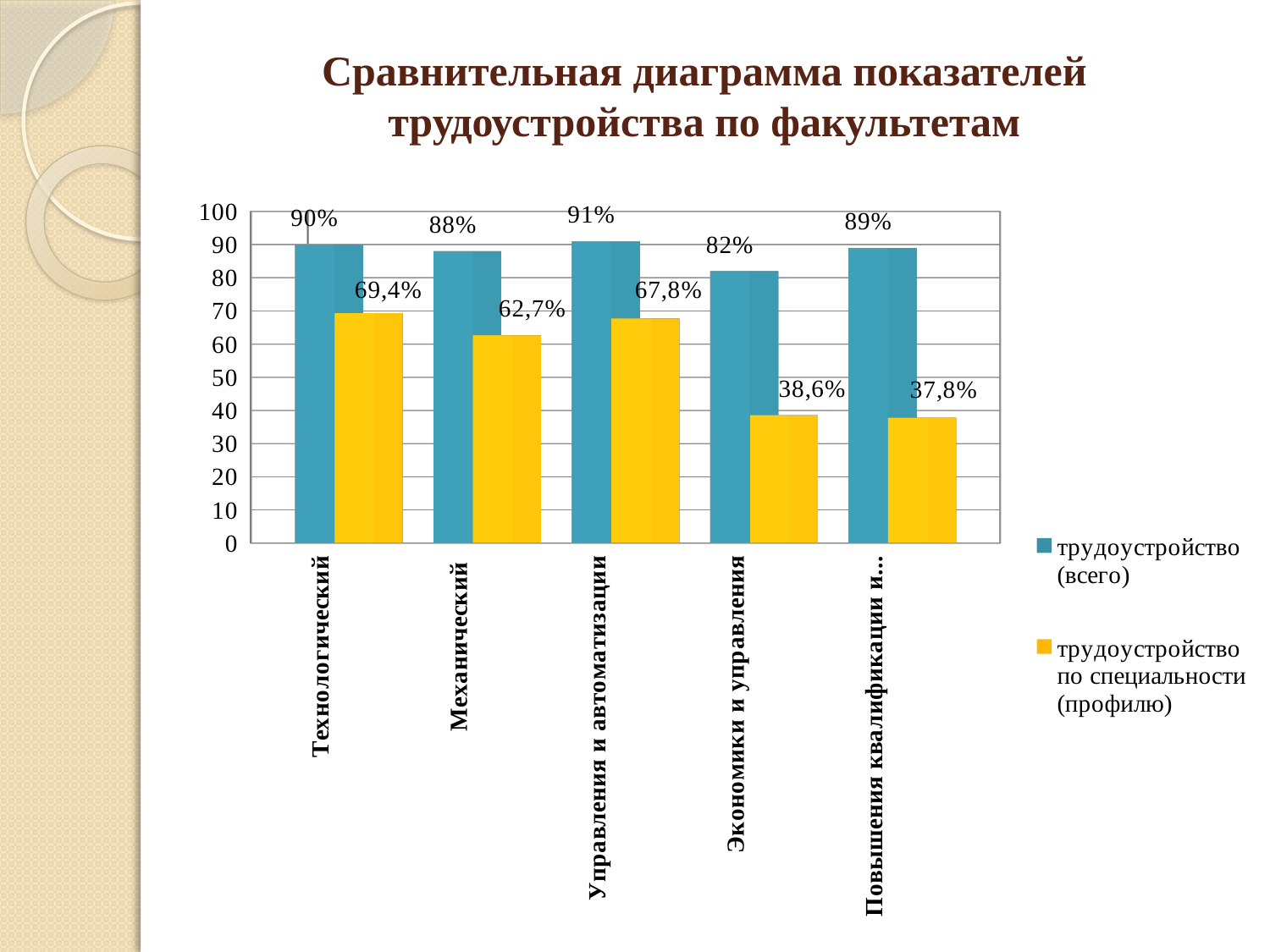
What is the difference between 'трудоустройство (всего)' and 'трудоустройство по специальности (профилю)' for the Управления и автоматизации faculty? 23,2% How many series does the legend list? 2 What is the value of 'трудоустройство (всего)' for the Технологический faculty? 90% Which is larger: 'трудоустройство по специальности (профилю)' for Технологический or for Механический? Технологический What is the value of 'трудоустройство по специальности (профилю)' for the Экономики и управления faculty? 38,6% How many faculties (categories) are shown on the x axis? 5 Which faculty has the highest value for 'трудоустройство (всего)'? Управления и автоматизации Which faculty has the lowest value for 'трудоустройство (всего)'? Экономики и управления Which faculty has the highest value for 'трудоустройство по специальности (профилю)'? Технологический What is the title of the chart on the slide? Сравнительная диаграмма показателей трудоустройства по факультетам What is the value of 'трудоустройство по специальности (профилю)' for the Механический faculty? 62,7% What type of chart is shown on the slide? bar chart